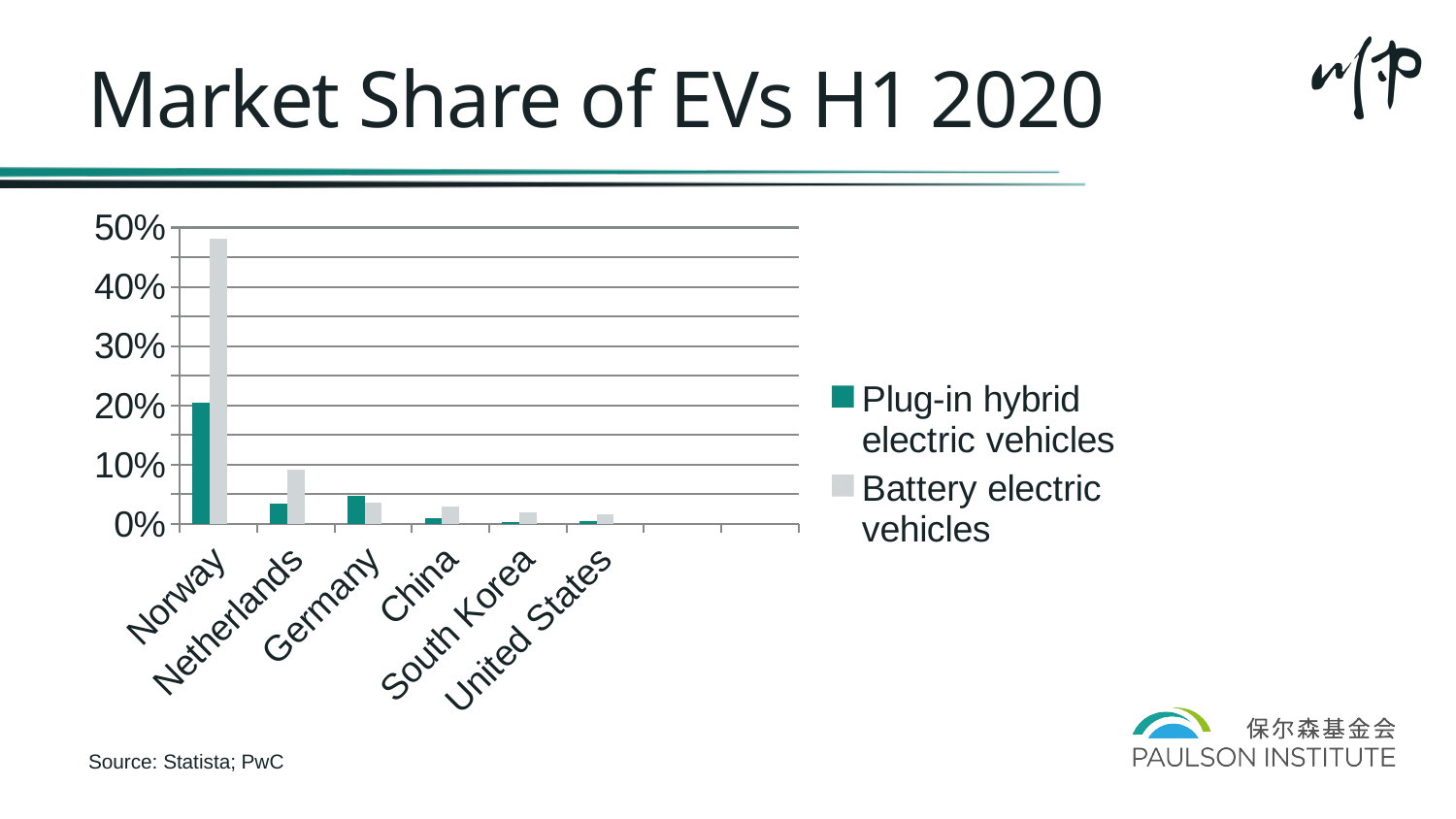
Which country has the highest market share of plug-in hybrid electric vehicles? Norway Which country has the highest market share of battery electric vehicles? Norway Which series is shown in dark green in the chart? Plug-in hybrid electric vehicles How many series does the legend list? 2 In Norway, which is larger: the share of battery electric vehicles or plug-in hybrid electric vehicles? Battery electric vehicles What sources are cited for the chart? Statista; PwC In the Netherlands, which is larger: the share of battery electric vehicles or plug-in hybrid electric vehicles? Battery electric vehicles Is the value for battery electric vehicles in Norway greater or less than 40%? greater What kind of chart is shown on the slide? Bar chart How many countries are shown on the x axis of the chart? 6 Is the value for plug-in hybrid electric vehicles in Norway greater or less than 10%? greater